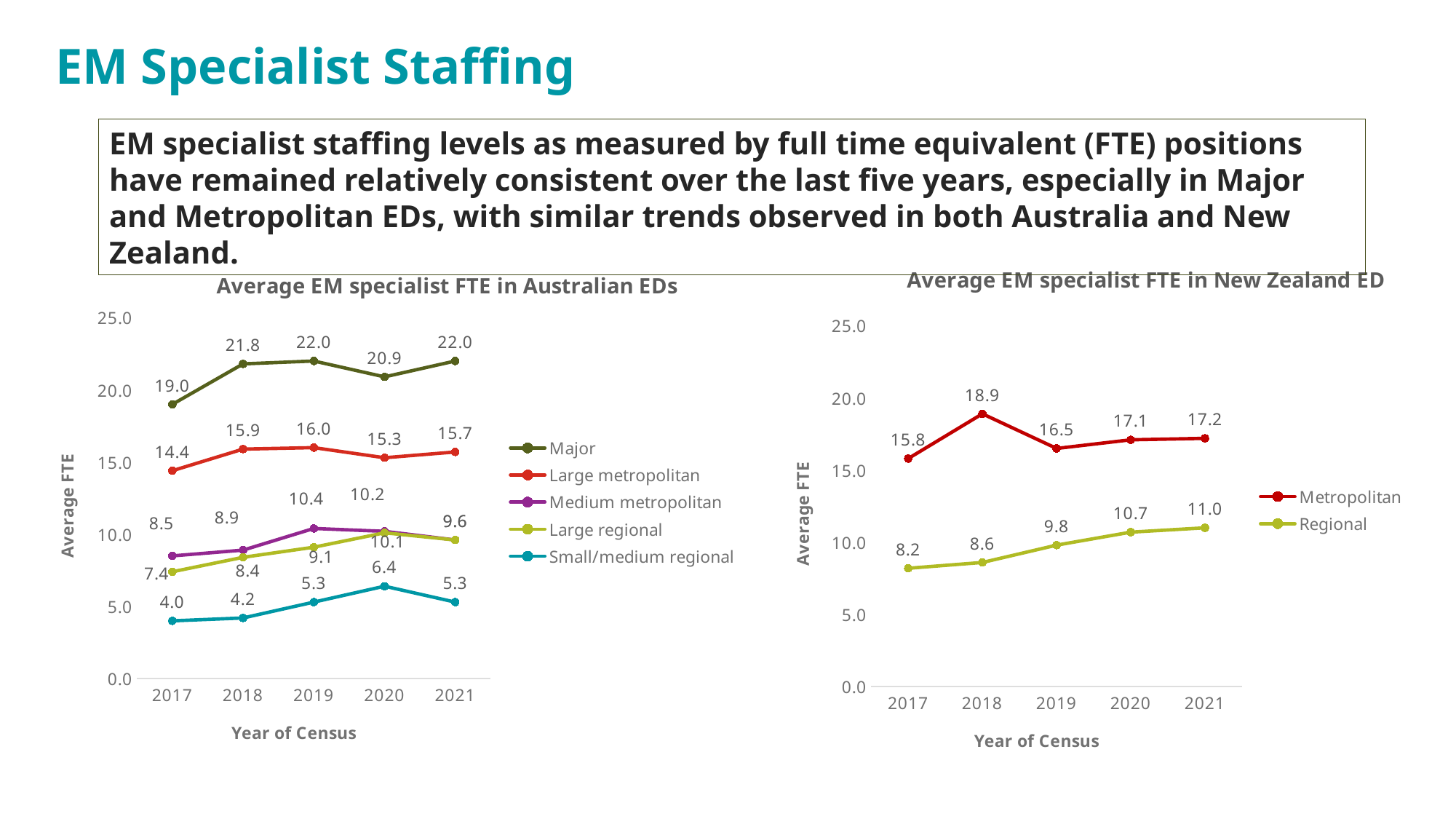
In the Average EM specialist FTE in Australian EDs chart, which year has the lowest value for Large metropolitan? 2017 In the Average EM specialist FTE in New Zealand ED chart, what is the difference between Metropolitan and Regional in 2021? 6.2 In the Average EM specialist FTE in New Zealand ED chart, which year has the highest value for Regional? 2021 In the Average EM specialist FTE in Australian EDs chart, what is the value for Major in 2018? 21.8 In the Average EM specialist FTE in Australian EDs chart, is the value for Major in 2017 greater or less than 20.0? less What kind of chart is the Average EM specialist FTE in New Zealand ED chart? line chart In the Average EM specialist FTE in Australian EDs chart, what is the value for Small/medium regional in 2020? 6.4 In the Average EM specialist FTE in New Zealand ED chart, what is the value for Metropolitan in 2018? 18.9 In the Average EM specialist FTE in Australian EDs chart, how many series does the legend list? 5 In the Average EM specialist FTE in Australian EDs chart, what is the difference between the Major values in 2021 and 2017? 3.0 In the Average EM specialist FTE in New Zealand ED chart, how many years are shown on the x axis? 5 In the Average EM specialist FTE in New Zealand ED chart, do the Regional values rise or fall from 2017 to 2021? rise